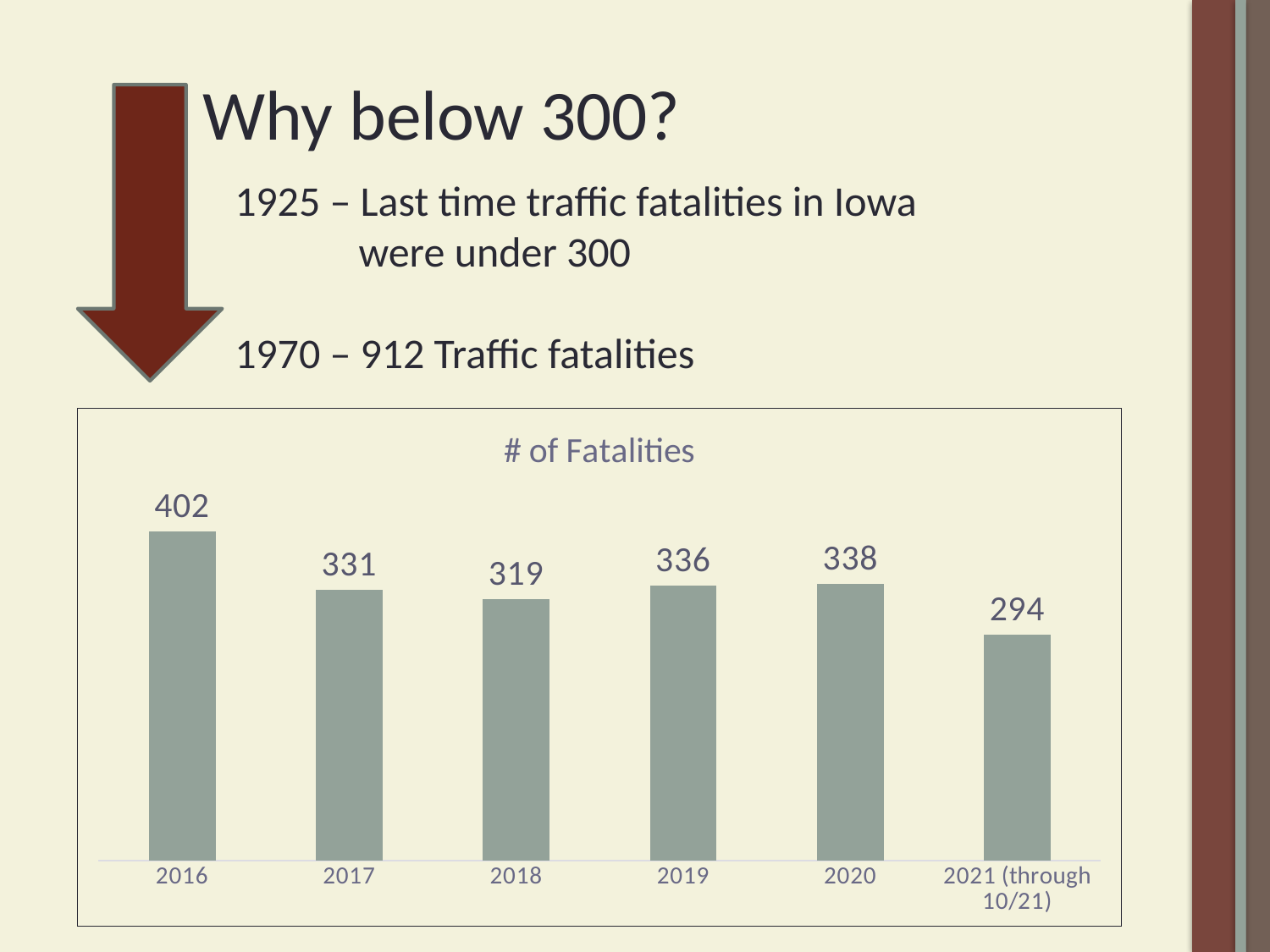
What kind of chart is shown on the slide? bar chart What is the number of fatalities for 2021 (through 10/21)? 294 What is the number of fatalities for 2018? 319 Do the fatality values generally rise or fall from 2016 to 2021? fall What is the difference in fatalities between 2020 and 2021 (through 10/21)? 44 Which year has the highest number of fatalities? 2016 How many bars are shown in the chart? 6 Which has more fatalities, 2019 or 2018? 2019 What is the title of the chart? # of Fatalities What is the difference in fatalities between 2016 and 2017? 71 Which category has the lowest number of fatalities? 2021 (through 10/21) What is the number of fatalities for 2016? 402